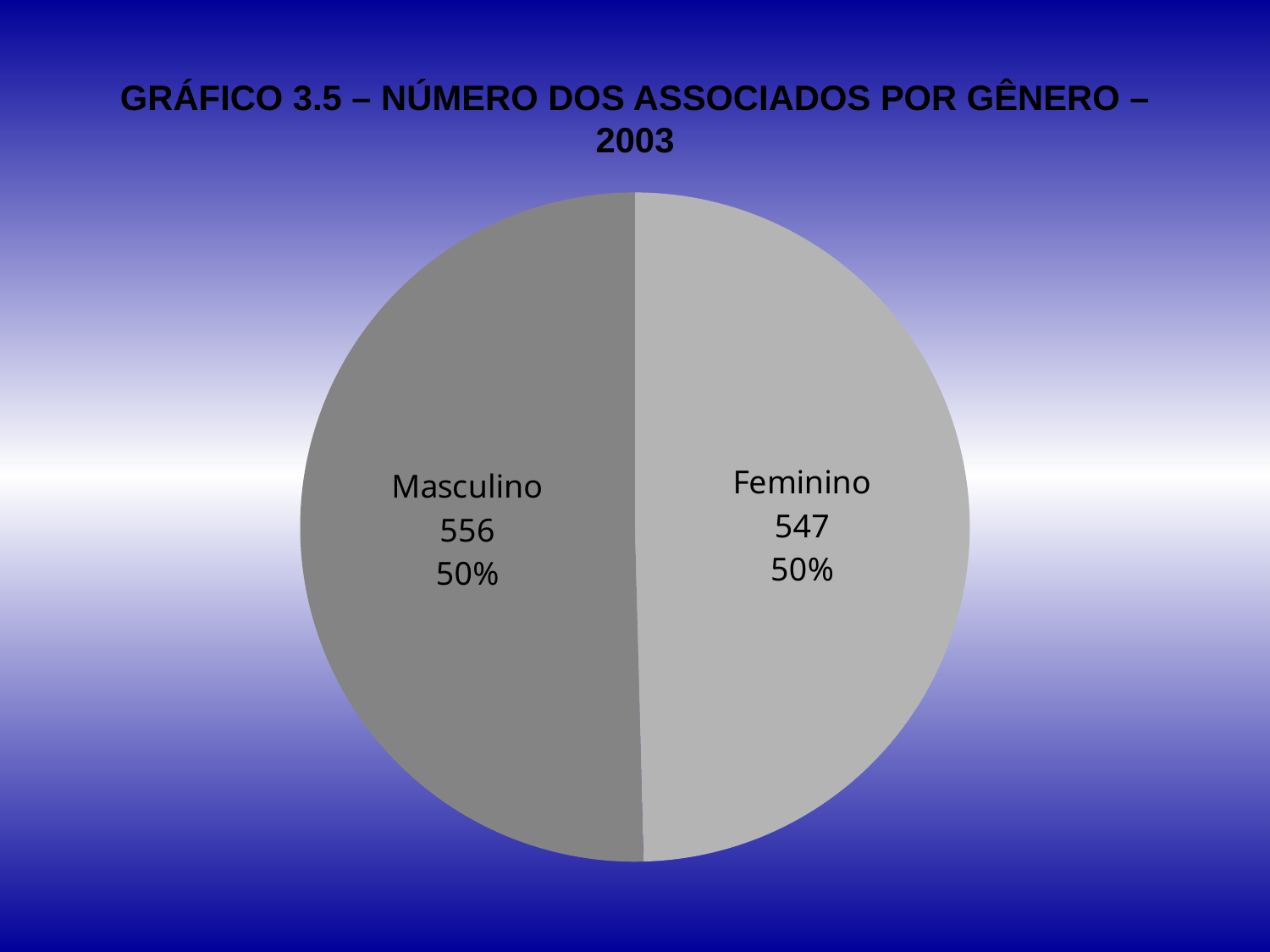
How many slices does the pie chart have? 2 What is the total number of associates across both slices? 1103 What is the number of associates for Masculino? 556 What percentage share is shown for the Masculino slice? 50% What year does the chart title refer to? 2003 Which slice is shown in the darker grey colour? Masculino Which category has the smallest number of associates? Feminino What kind of chart is shown on the slide? Pie chart What percentage share is shown for the Feminino slice? 50% Which category has the larger number of associates, Masculino or Feminino? Masculino What is the number of associates for Feminino? 547 What is the difference between the Masculino and Feminino values? 9